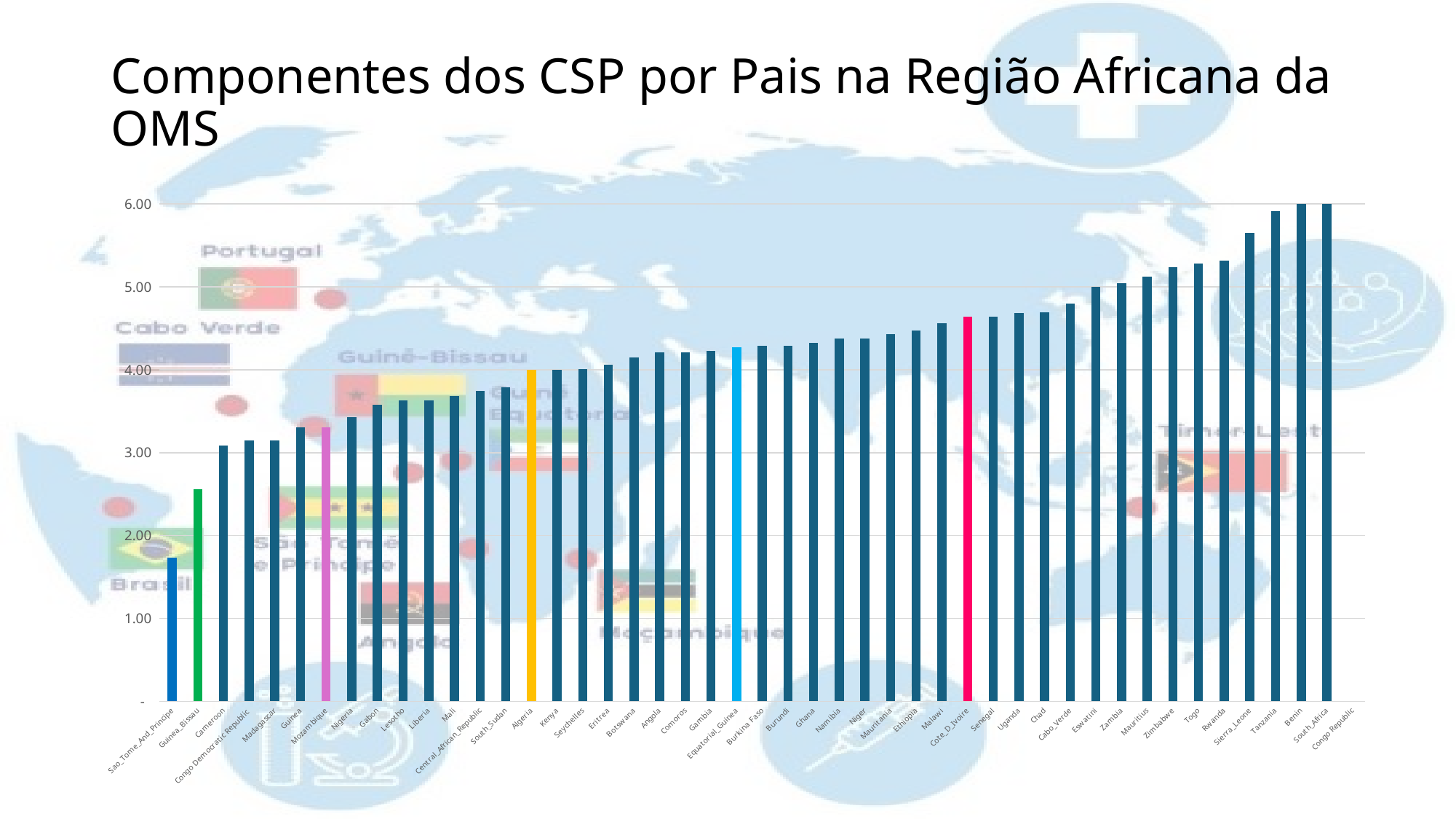
What colour is the bar for Algeria? yellow Is the value for Cameroon greater or less than 3.00? greater Is the value for Sao_Tome_And_Principe greater or less than 2.00? less Which has the larger value, Kenya or Malawi? Malawi Which country has the lowest value in the chart? Sao_Tome_And_Principe Is the value for Tanzania greater or less than 5.00? greater What is the title of the chart on the slide? Componentes dos CSP por Pais na Região Africana da OMS Which has the larger value, Guinea_Bissau or Cameroon? Cameroon What kind of chart is shown on the slide? bar chart Do the values generally rise or fall from left to right along the x axis? rise